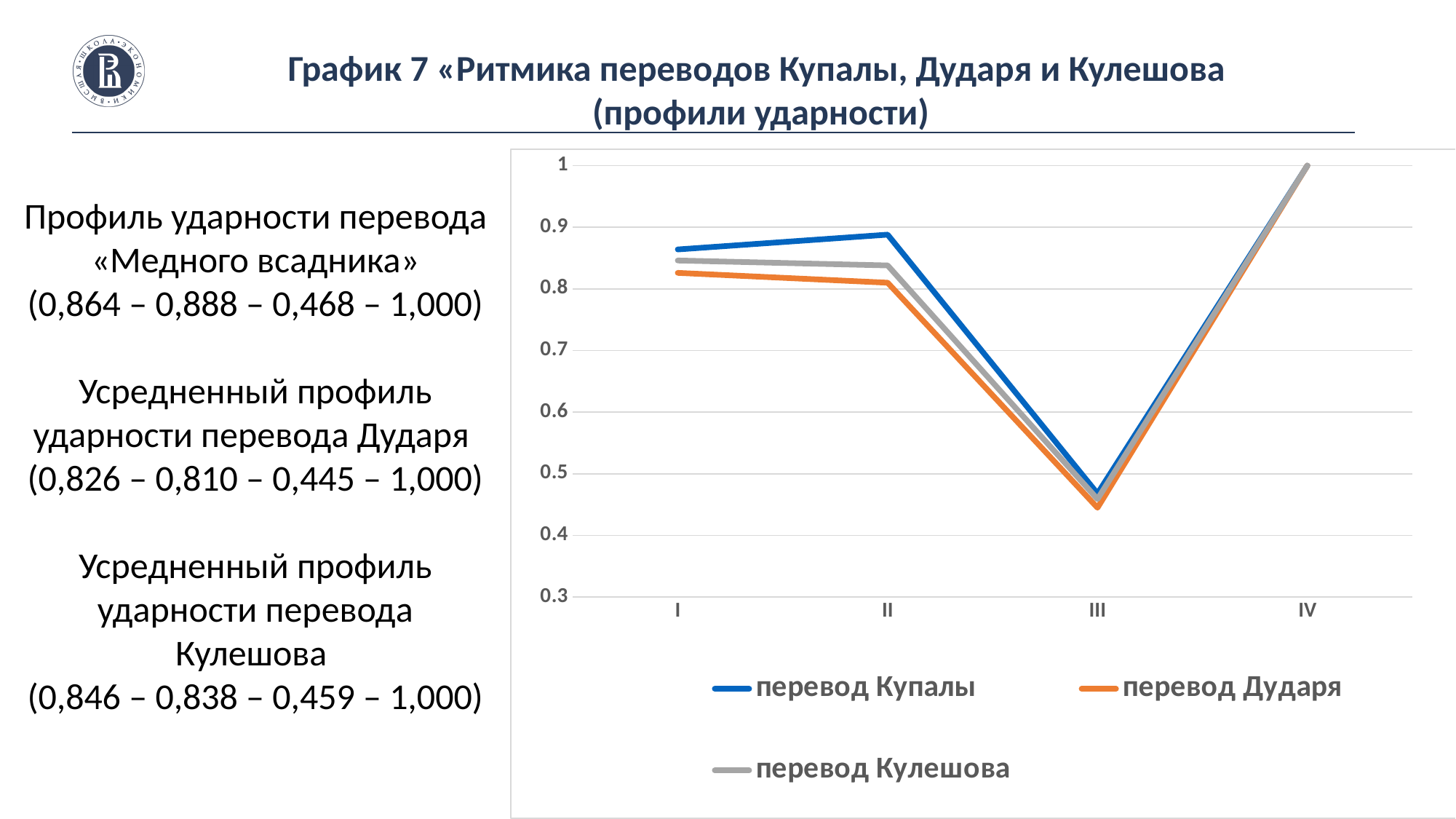
What kind of chart is shown on the slide? line chart At which position does перевод Дударя reach its lowest value? III How many points are plotted along the x axis for each series? 4 Do the values for all three series rise or fall from position II to position III? fall Is the value for перевод Купалы at position II greater or less than 0.8? greater What colour is the line for перевод Дударя in the legend? orange How many series does the chart legend list? 3 At which position does перевод Кулешова reach its highest value? IV What is the value for перевод Купалы at position IV? 1 Is the value for перевод Дударя at position III greater or less than 0.5? less At position II, which series has the higher value: перевод Купалы or перевод Дударя? перевод Купалы Do the values for all three series rise or fall from position III to position IV? rise